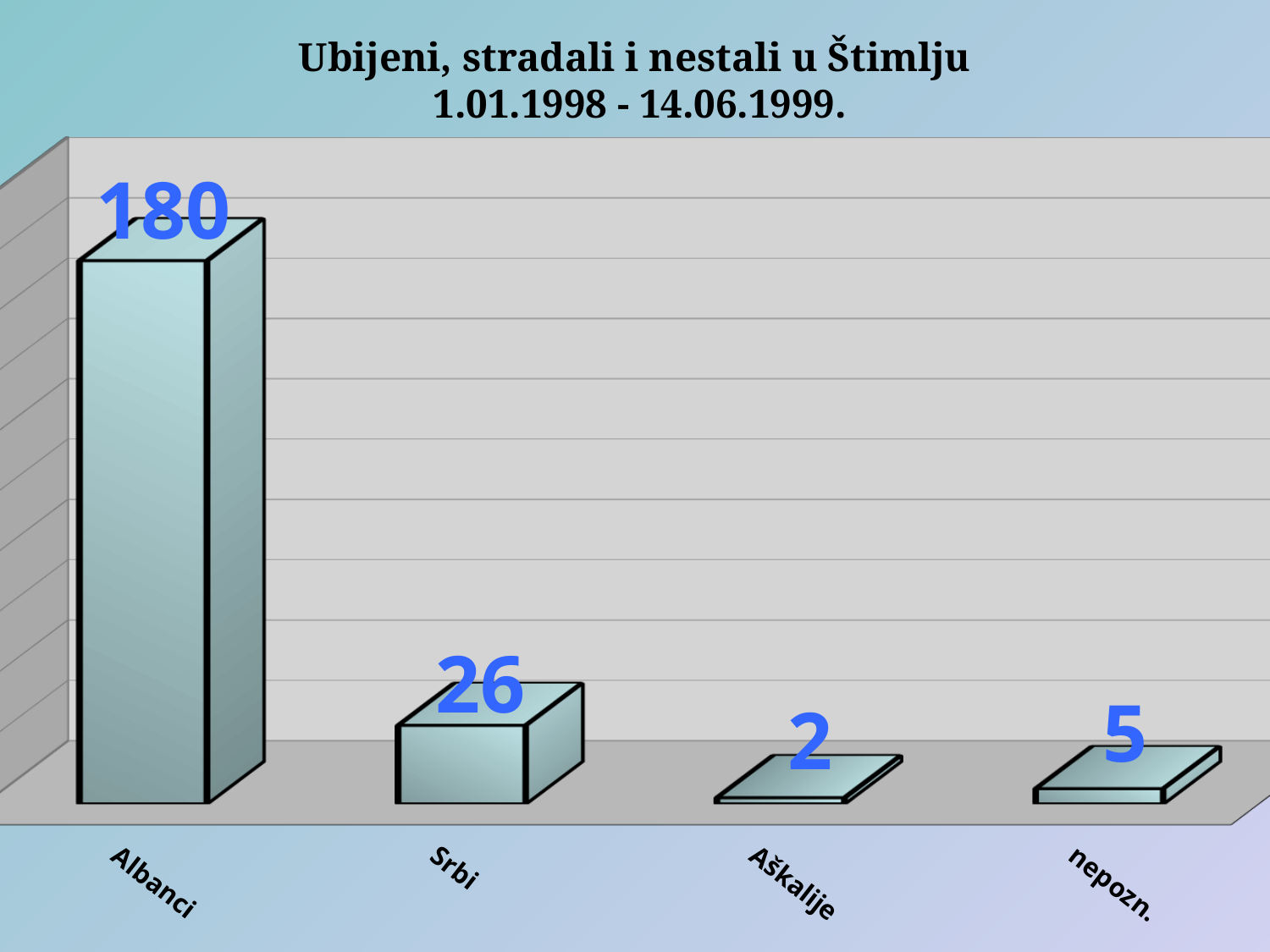
What is the difference between the values for Albanci and Srbi? 154 What is the value for Aškalije? 2 What is the value for Srbi? 26 How many categories are shown in the chart? 4 What is the title of the chart? Ubijeni, stradali i nestali u Štimlju 1.01.1998 - 14.06.1999. What is the value for Albanci? 180 Which category has the lowest value? Aškalije What is the value for nepozn.? 5 What is the difference between the values for nepozn. and Aškalije? 3 Which is larger, the value for Srbi or the value for nepozn.? Srbi What kind of chart is shown on the slide? Bar chart Which category has the highest value? Albanci